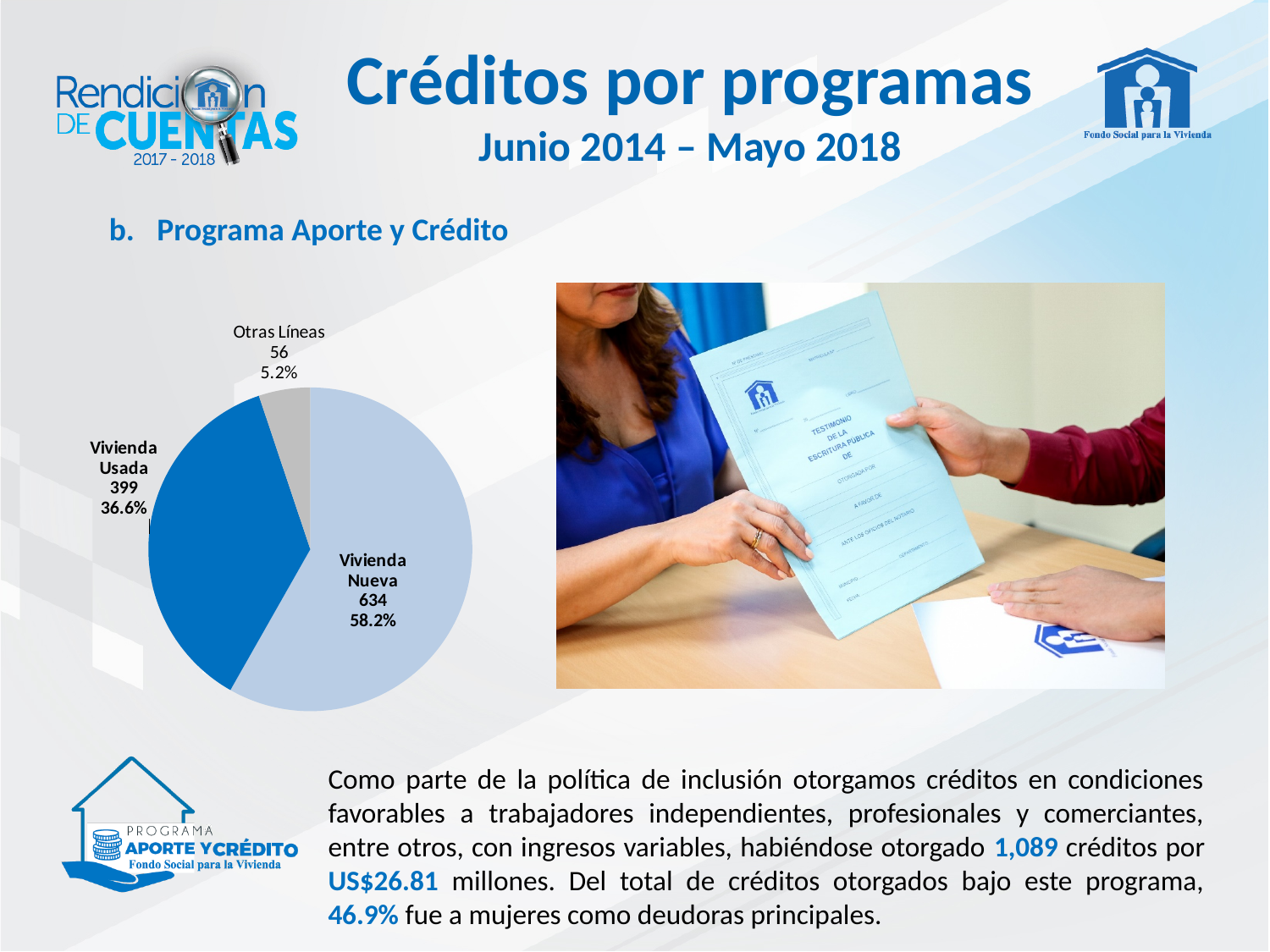
Which has more credits, Vivienda Usada or Otras Líneas? Vivienda Usada How many credits are shown for Vivienda Nueva? 634 What share of the pie does Vivienda Usada represent? 36.6% What is the total number of credits across all three slices of the pie? 1,089 What kind of chart is shown on the slide? pie chart Which category has the largest slice of the pie? Vivienda Nueva How many categories does the pie chart have? 3 What share of the pie does Otras Líneas represent? 5.2% How many credits are shown for Vivienda Usada? 399 What is the difference in credits between Vivienda Nueva and Vivienda Usada? 235 Which category has the smallest slice of the pie? Otras Líneas How many credits are shown for Otras Líneas? 56